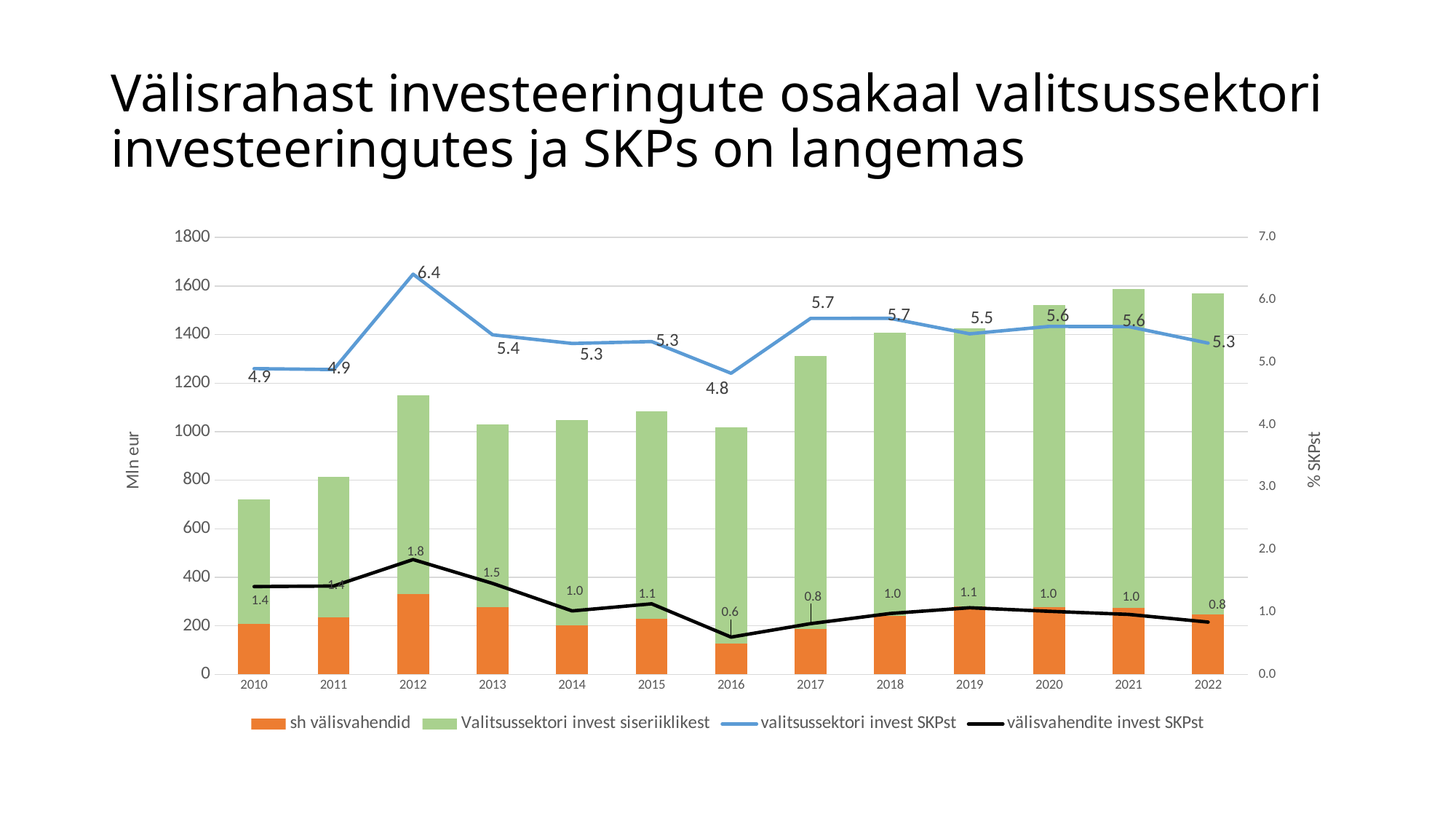
What is the value of the 'valitsussektori invest SKPst' line in 2012? 6.4 Does the 'välisvahendite invest SKPst' line rise or fall from 2012 to 2016? fall Which year has the larger 'välisvahendite invest SKPst' value, 2013 or 2014? 2013 How many years are shown on the x axis? 13 Is the total height of the stacked bar for 2022 greater or less than 1400? greater What is the value of the 'välisvahendite invest SKPst' line in 2016? 0.6 In which year is the 'välisvahendite invest SKPst' line highest? 2012 In which year does the 'valitsussektori invest SKPst' line reach its highest value? 2012 How many series does the legend list? 4 In which year is the 'valitsussektori invest SKPst' line at its lowest? 2016 What kind of chart is shown on the slide? Combined stacked bar and line chart What is the difference between the 'valitsussektori invest SKPst' values in 2012 and 2016? 1.6